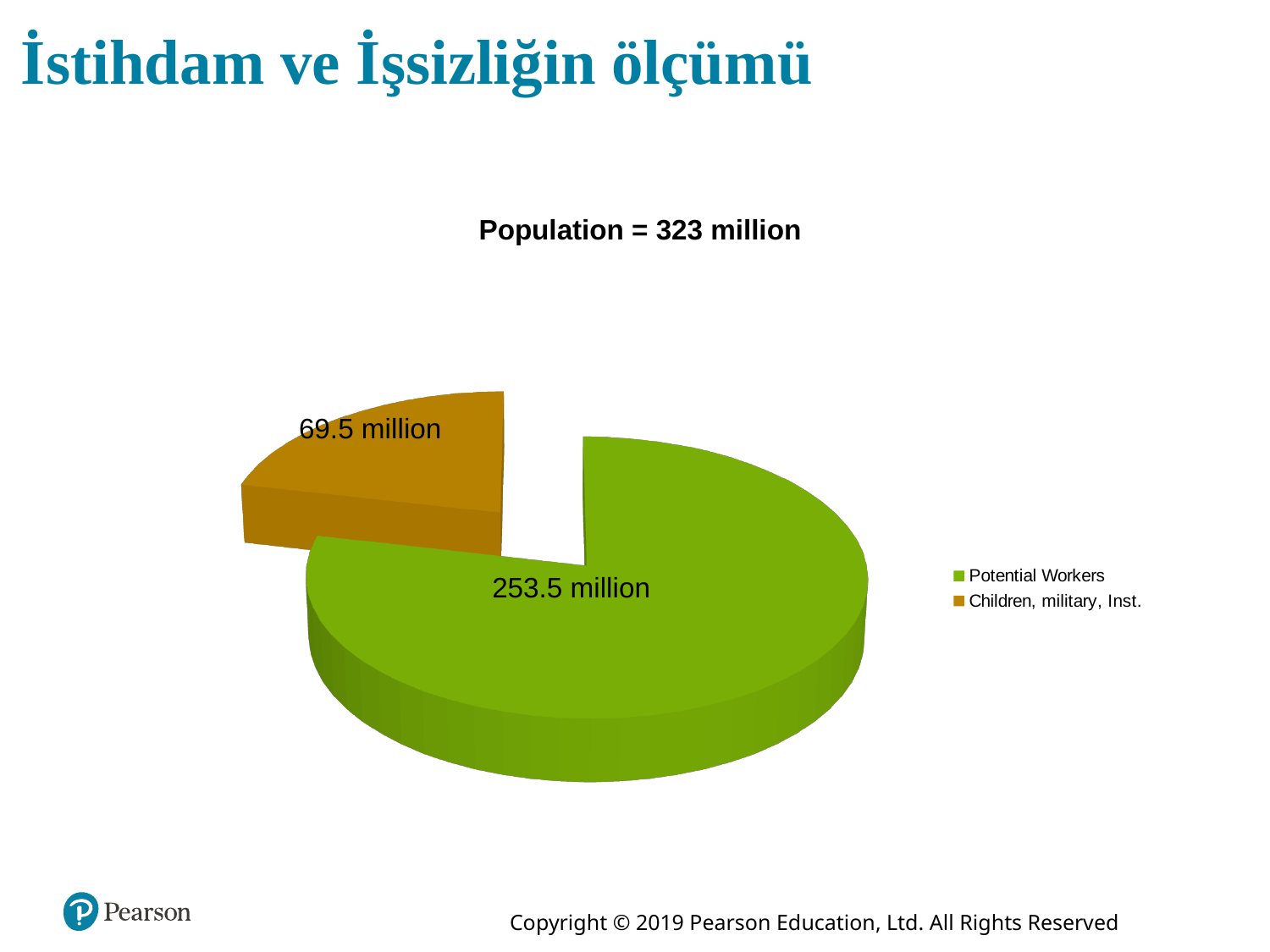
What is the difference between the Potential Workers value and the Children, military, Inst. value? 184 million What is the value for Children, military, Inst.? 69.5 million What colour is the Potential Workers slice? Green What is the value for Potential Workers? 253.5 million How many entries does the legend list? 2 What total population does the chart title state? 323 million Which category has the largest slice of the pie? Potential Workers What share of the total population do Potential Workers represent? 78.5% What type of chart is shown on the slide? Pie chart Which is larger: Potential Workers or Children, military, Inst.? Potential Workers How many slices does the pie chart have? 2 Which category has the smallest slice of the pie? Children, military, Inst.